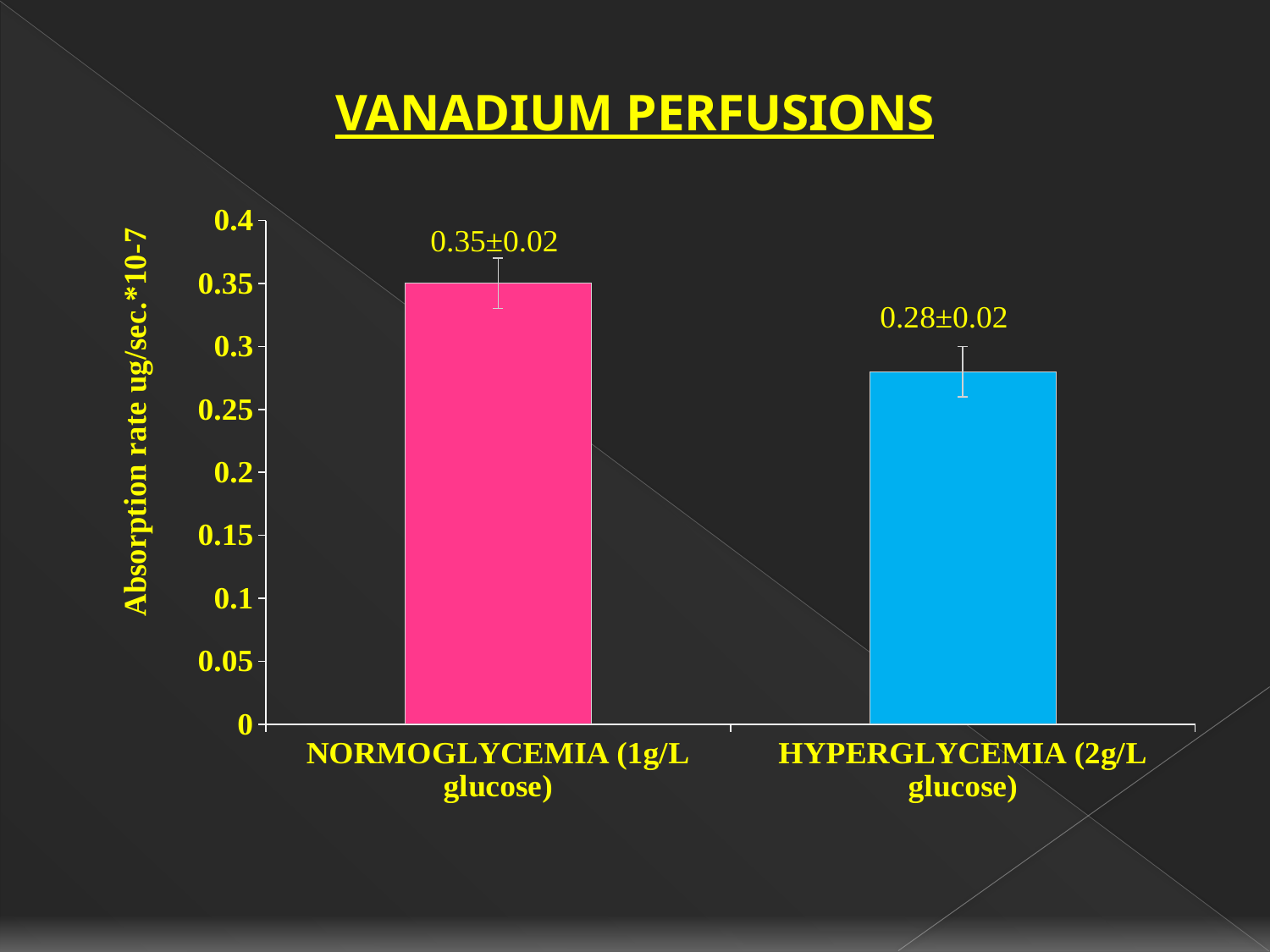
Which condition has the higher absorption rate? NORMOGLYCEMIA (1g/L glucose) What kind of chart is shown on the slide? bar chart What is the title of the chart? VANADIUM PERFUSIONS What is the difference between the mean absorption rates for NORMOGLYCEMIA and HYPERGLYCEMIA? 0.07 Is the value for HYPERGLYCEMIA (2g/L glucose) greater or less than 0.3? less Which condition has the lower absorption rate? HYPERGLYCEMIA (2g/L glucose) Is the absorption rate larger for NORMOGLYCEMIA (1g/L glucose) or HYPERGLYCEMIA (2g/L glucose)? NORMOGLYCEMIA (1g/L glucose) Is the value for NORMOGLYCEMIA (1g/L glucose) greater or less than 0.3? greater How many categories are shown on the x axis? 2 What is the absorption rate for NORMOGLYCEMIA (1g/L glucose)? 0.35±0.02 What is the label of the y axis? Absorption rate ug/sec.*10-7 What is the absorption rate for HYPERGLYCEMIA (2g/L glucose)? 0.28±0.02